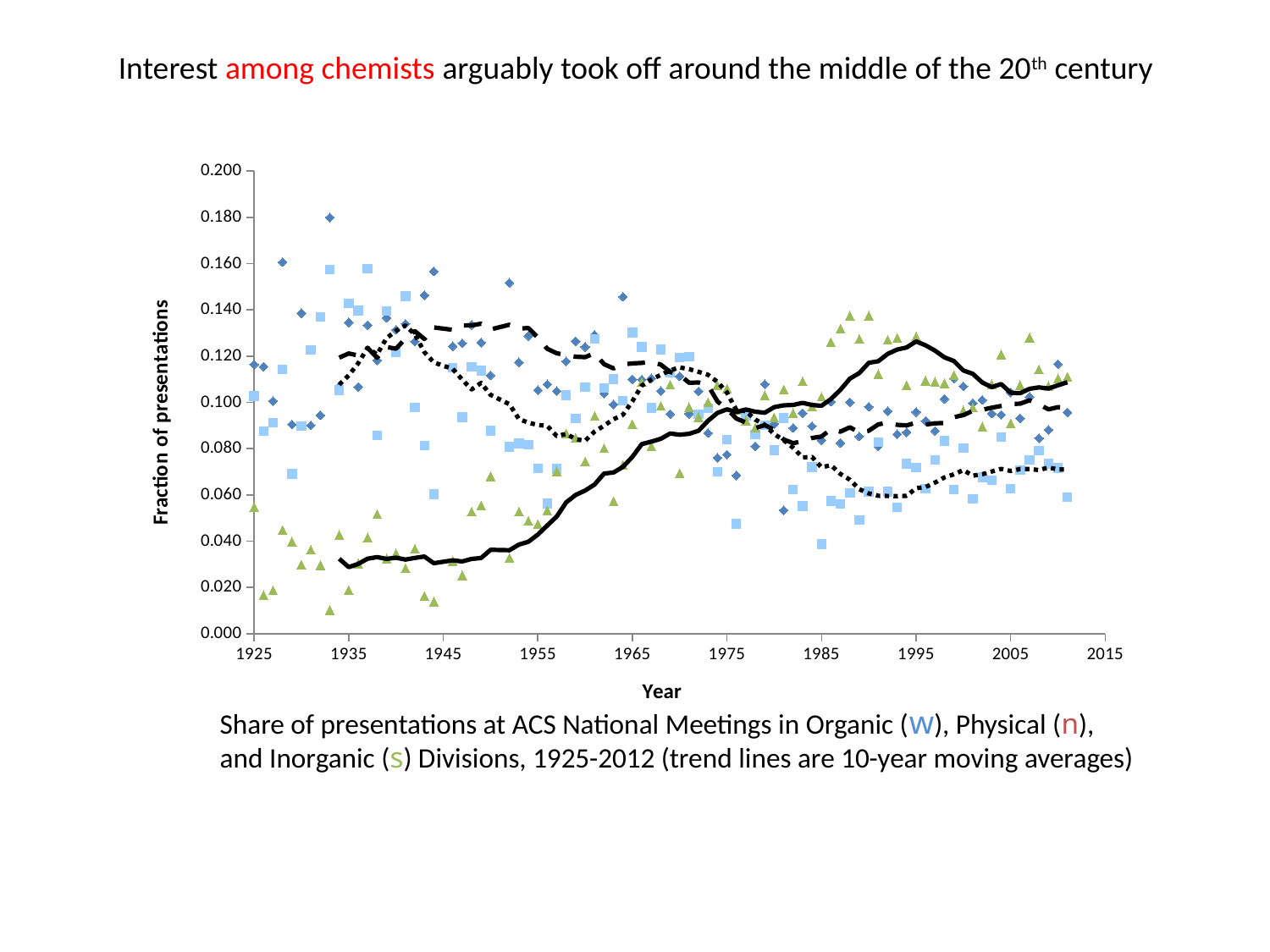
How many ACS divisions (data series) are plotted in the chart according to the caption? 3 Which division has the lowest share of presentations in the 1930s? Inorganic Does the solid trend line for the Inorganic Division rise or fall from 1935 to 2010? Rises Does the dashed trend line for the Organic Division rise or fall from 1945 to 2010? Falls What is the label of the horizontal axis of the chart? Year Is the Inorganic Division value in 1925 greater or less than 0.080? less What is the maximum value shown on the vertical axis of the chart? 0.200 Is the highest Organic Division point (around 1933) greater or less than 0.160? greater Which division has the highest share of presentations around 1990? Inorganic What is the label of the vertical axis of the chart? Fraction of presentations What kind of chart is shown on the slide? Scatter chart Does the dotted trend line for the Physical Division rise or fall from 1965 to 1995? Falls